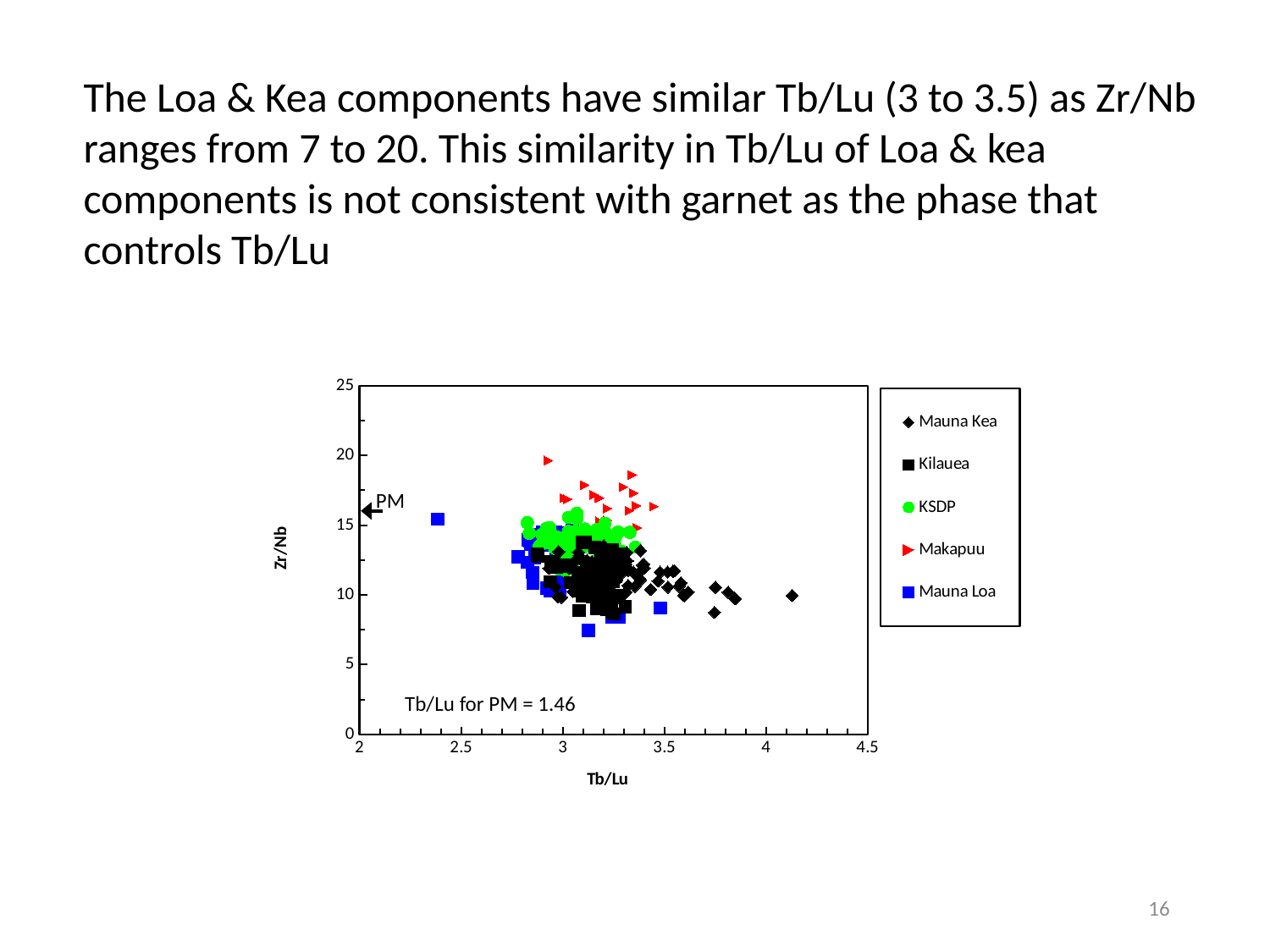
Which series are listed in the legend? Mauna Kea, Kilauea, KSDP, Makapuu, Mauna Loa What is the maximum value shown on the Zr/Nb axis? 25 What kind of chart is shown on the slide? scatter chart How many series does the legend list? 5 Which series contains the point with the highest Zr/Nb value? Makapuu Is the Zr/Nb value of the lowest Mauna Loa point greater or less than 10? less What is the label of the vertical axis? Zr/Nb What value of Tb/Lu for PM is stated on the chart? 1.46 Which series contains the point with the lowest Zr/Nb value? Mauna Loa Is the Zr/Nb value of the highest Makapuu point greater or less than 15? greater Is the Tb/Lu value of the rightmost Mauna Kea point greater or less than 4? greater Which series contains the point with the highest Tb/Lu value? Mauna Kea